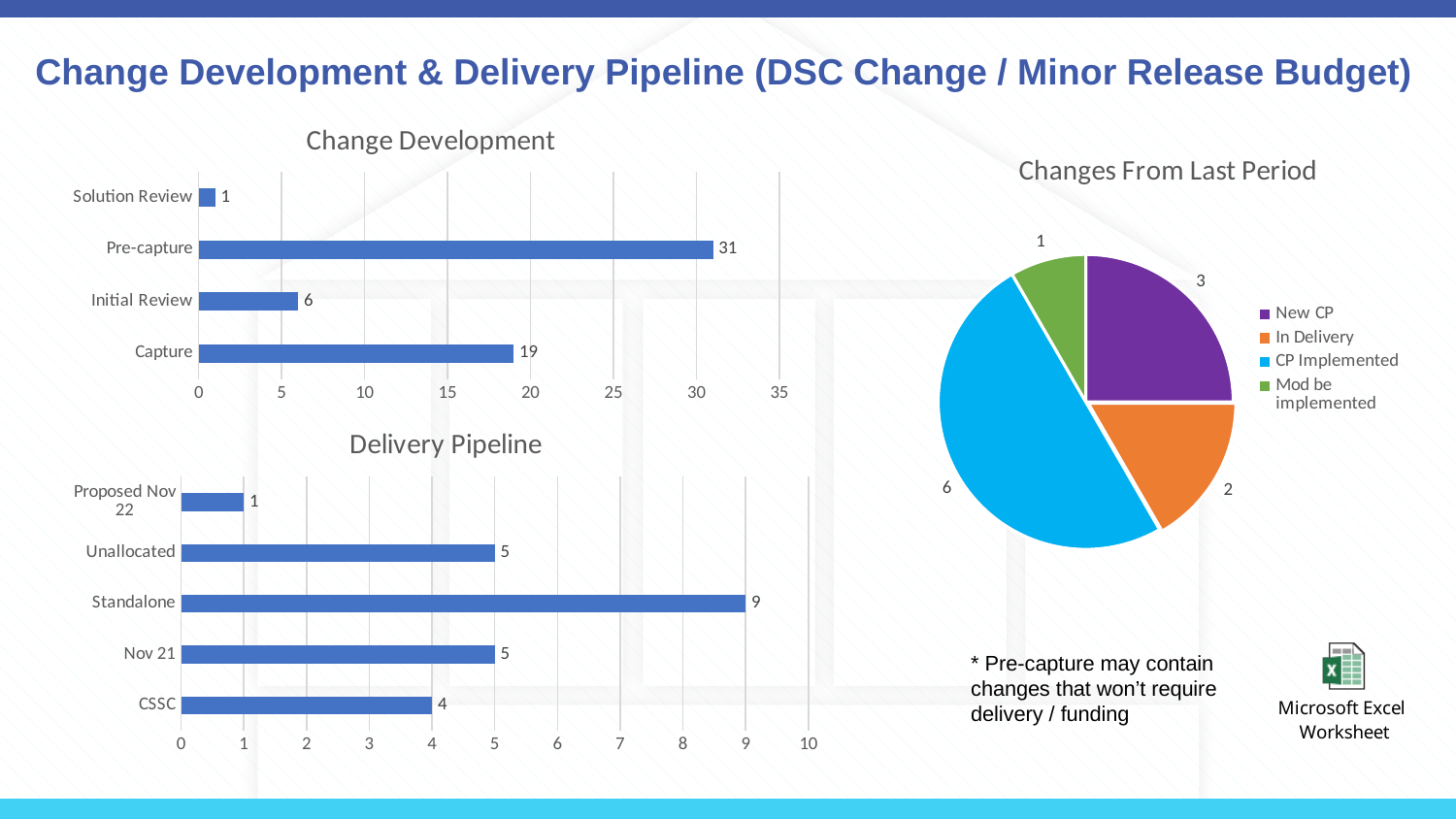
In the Change Development chart, which category has the lowest value? Solution Review In the Changes From Last Period chart, what share of the total does CP Implemented represent? 50% In the Change Development chart, how many categories are shown? 4 In the Delivery Pipeline chart, what is the value for CSSC? 4 How many entries does the legend of the Changes From Last Period chart list? 4 In the Change Development chart, what is the value for Pre-capture? 31 In the Delivery Pipeline chart, how many categories are shown? 5 What kind of chart is the Delivery Pipeline chart? Bar chart In the Change Development chart, what is the difference between Pre-capture and Capture? 12 In the Delivery Pipeline chart, which category has the highest value? Standalone In the Changes From Last Period chart, what is the value for In Delivery? 2 In the Delivery Pipeline chart, which is larger, Unallocated or CSSC? Unallocated